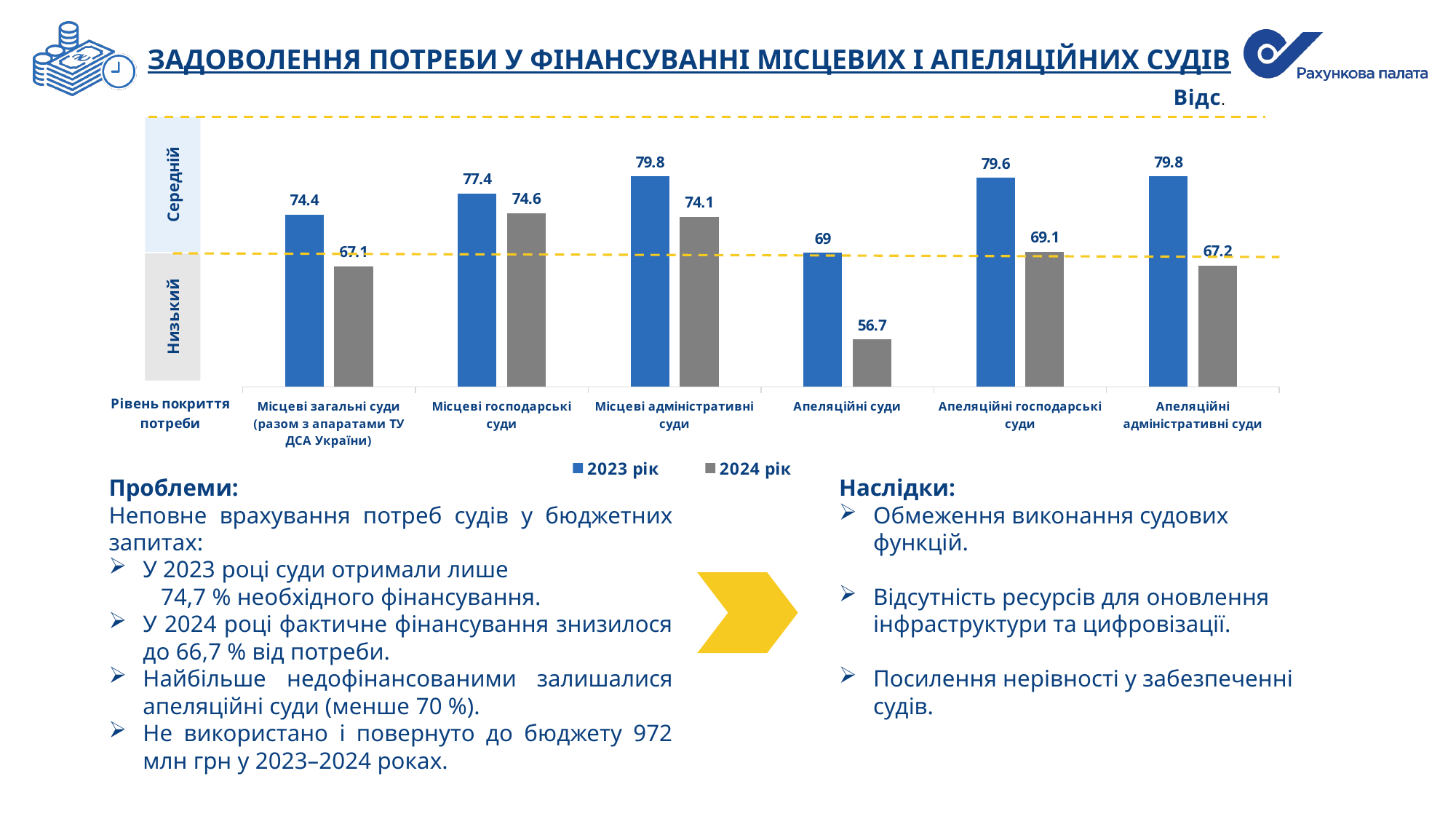
Which is larger for Місцеві адміністративні суди: the 2023 рік value or the 2024 рік value? 2023 рік Which colour represents the 2024 рік series in the chart? grey Which category has the highest value for 2024 рік? Місцеві господарські суди How many series does the chart legend list? 2 What is the value for Апеляційні суди in 2024 рік? 56.7 Which category has the lowest value for 2024 рік? Апеляційні суди What is the difference between the 2023 рік and 2024 рік values for Апеляційні суди? 12.3 What type of chart is shown on the slide? bar chart How many court categories are shown on the x axis of the chart? 6 What is the value for Місцеві господарські суди in 2023 рік? 77.4 What is the value for Апеляційні господарські суди in 2024 рік? 69.1 Which category has the lowest value for 2023 рік? Апеляційні суди